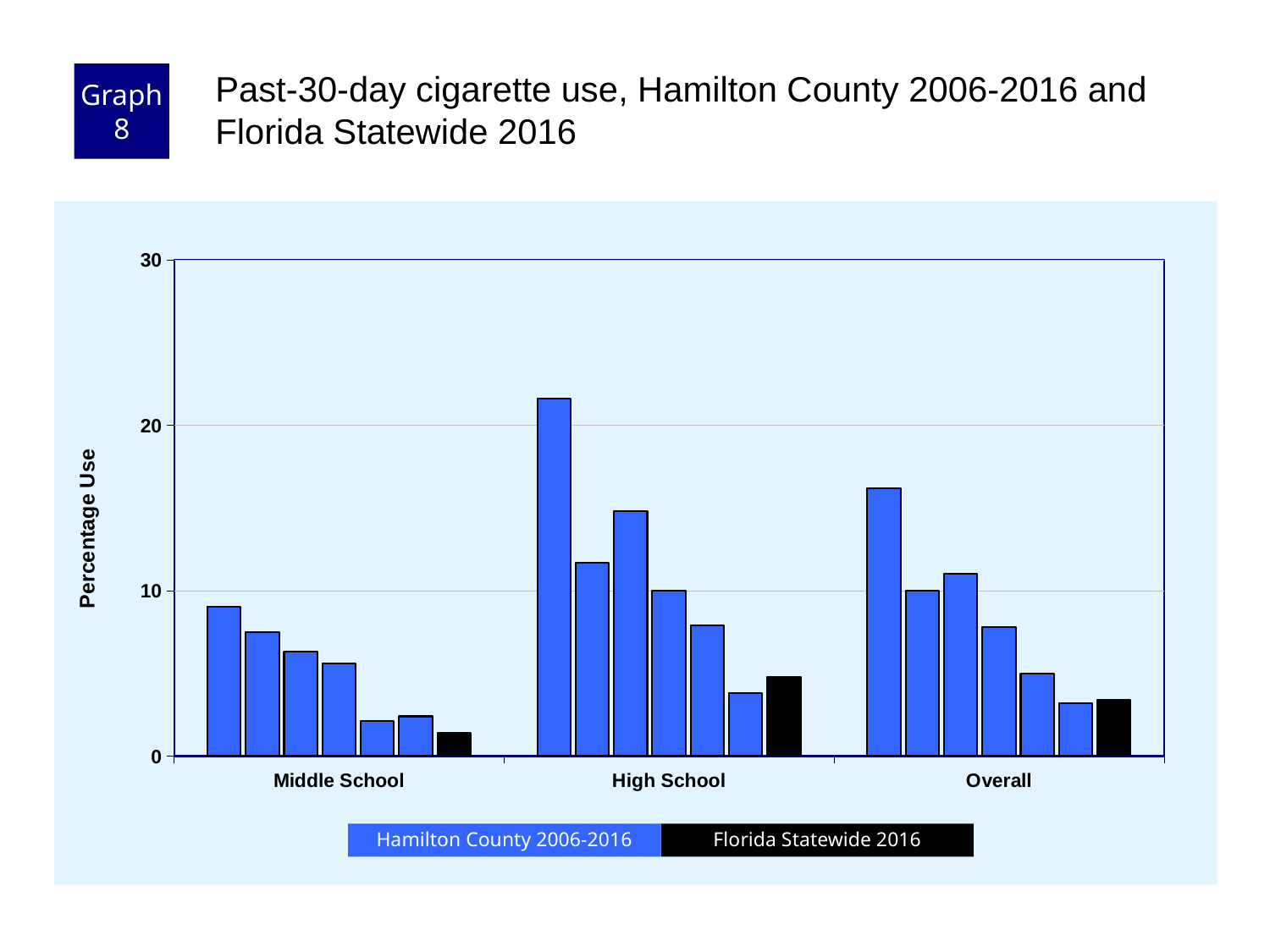
Is the tallest Hamilton County 2006-2016 bar for Overall greater or less than 10? greater Is the tallest Hamilton County 2006-2016 bar for High School greater or less than 20? greater Is the tallest Hamilton County 2006-2016 bar for Middle School greater or less than 10? less How many categories are shown on the x axis? 3 Which colour represents Florida Statewide 2016 in the legend? black Which category contains the tallest bar in the chart? High School What is the label on the y axis? Percentage Use Which is larger, the tallest bar in the High School group or the tallest bar in the Overall group? High School How many series does the legend list? 2 Which is larger, the Florida Statewide 2016 bar for High School or the Florida Statewide 2016 bar for Middle School? High School What kind of chart is shown on the slide? bar chart